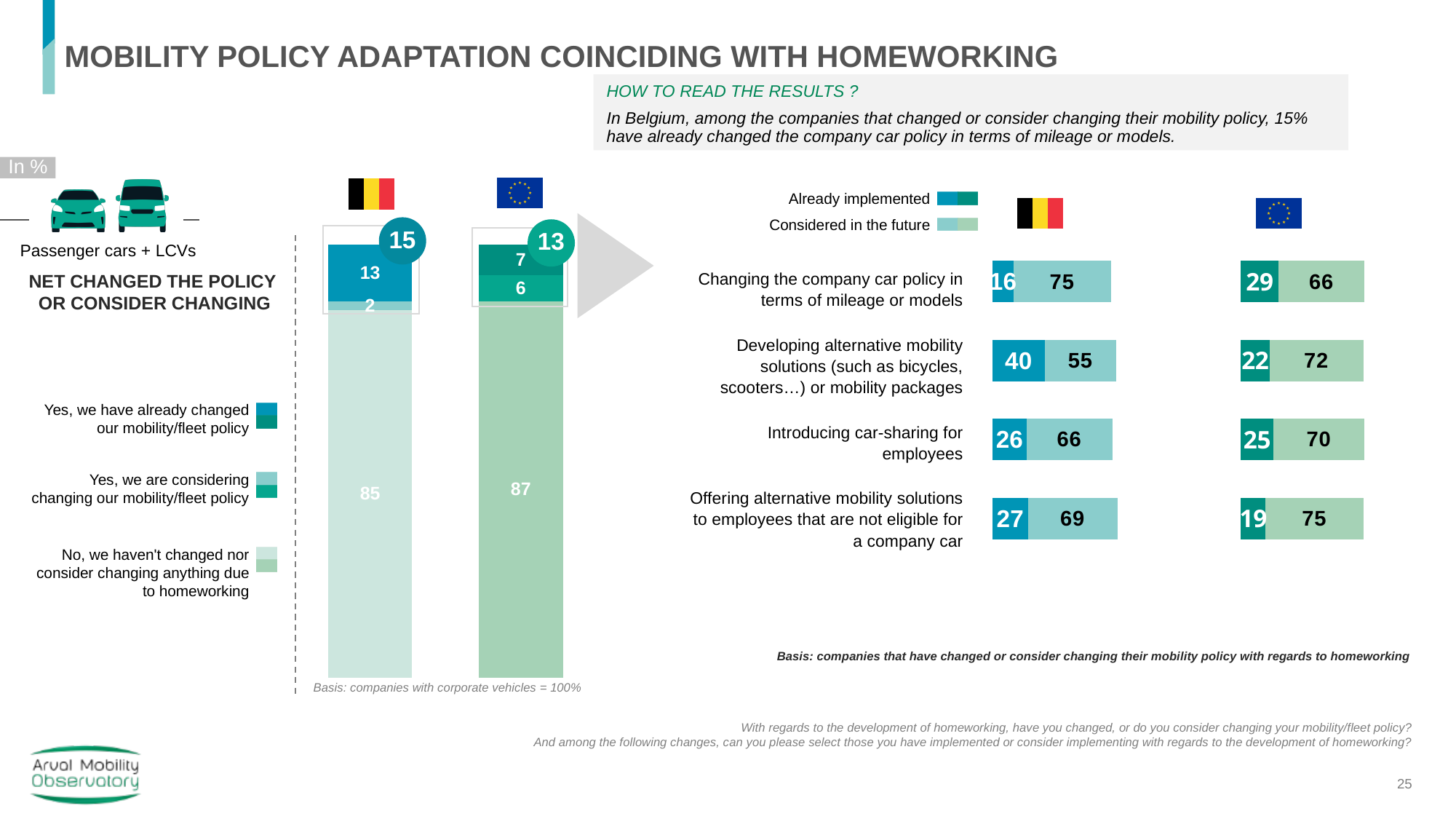
In the right chart, how many changes (categories) are listed? 4 In the right chart, which change has the highest 'already implemented' share for Belgium? Developing alternative mobility solutions (such as bicycles, scooters…) or mobility packages In the right chart, which change has the lowest 'already implemented' share for Europe? Offering alternative mobility solutions to employees that are not eligible for a company car In the left stacked bar chart, how many series does the legend list? 3 In the left stacked bar chart, what is the net share of European companies that changed the policy or consider changing it? 13 In the left stacked bar chart, what is the net share of Belgian companies that changed the policy or consider changing it? 15 In the left stacked bar chart, what percentage of Belgian companies have already changed their mobility/fleet policy? 13 In the right chart, is the 'already implemented' share for introducing car-sharing for employees larger for Belgium or for Europe? Belgium In the left stacked bar chart, what percentage of European companies have not changed nor consider changing anything due to homeworking? 87 In the right chart, what percentage of Belgian companies have already implemented developing alternative mobility solutions or mobility packages? 40 In the left stacked bar chart, what is the difference between the 'already changed' share for Belgium and for Europe? 6 In the right chart, what percentage of European companies consider in the future offering alternative mobility solutions to employees not eligible for a company car? 75